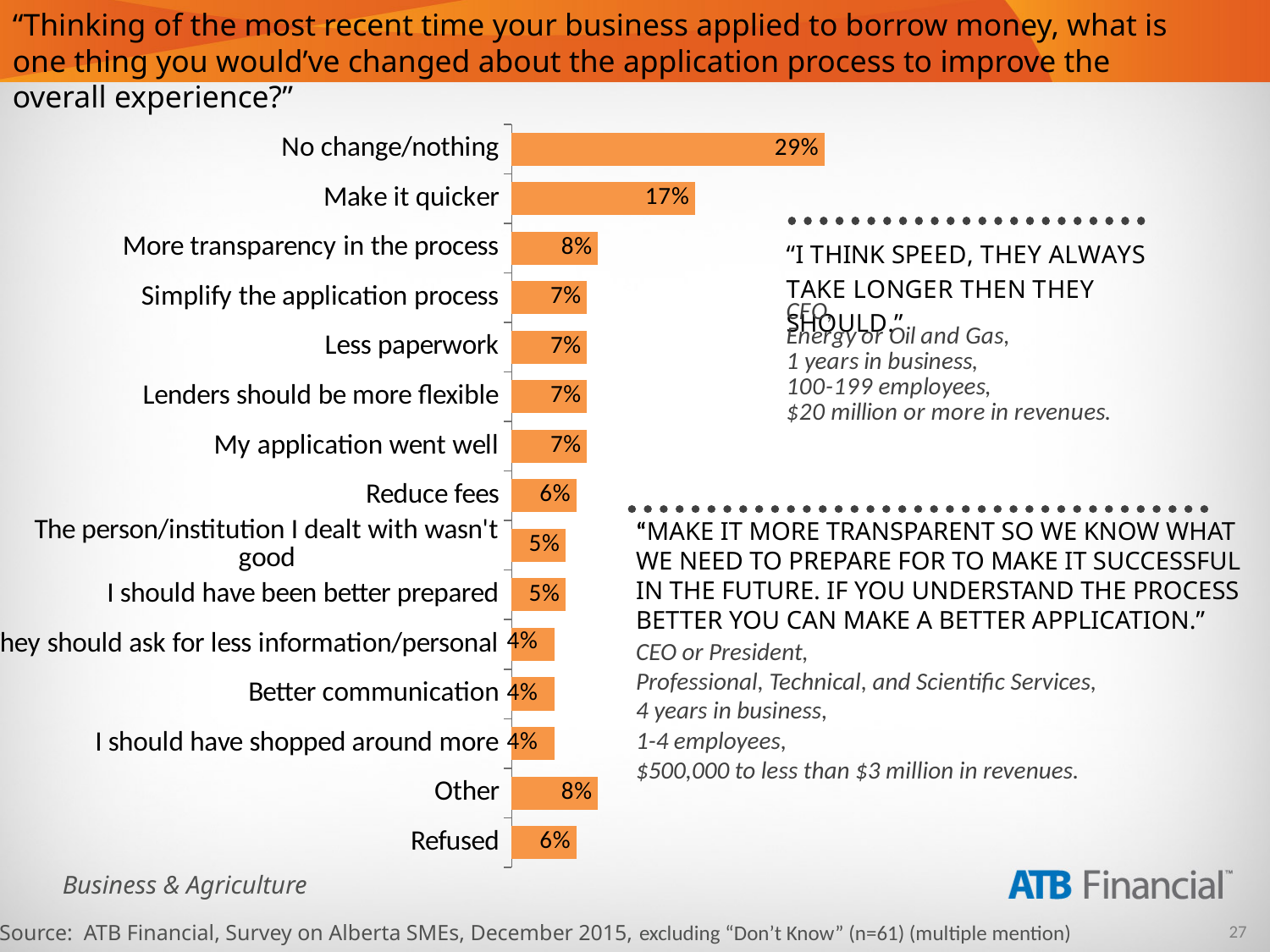
What is the value for "Reduce fees"? 6% What is the difference between "No change/nothing" and "Make it quicker"? 12 percentage points What type of chart is shown on the slide? Bar chart Which is larger, "Other" or "Refused"? Other What is the difference between "Make it quicker" and "More transparency in the process"? 9 percentage points How many categories are shown in the bar chart? 15 What percentage of respondents said "No change/nothing"? 29% Which category has the highest value? No change/nothing What percentage is shown for "Better communication"? 4% What percentage is shown for "More transparency in the process"? 8% What is the value for "Make it quicker"? 17% Which is larger, "Reduce fees" or "I should have been better prepared"? Reduce fees